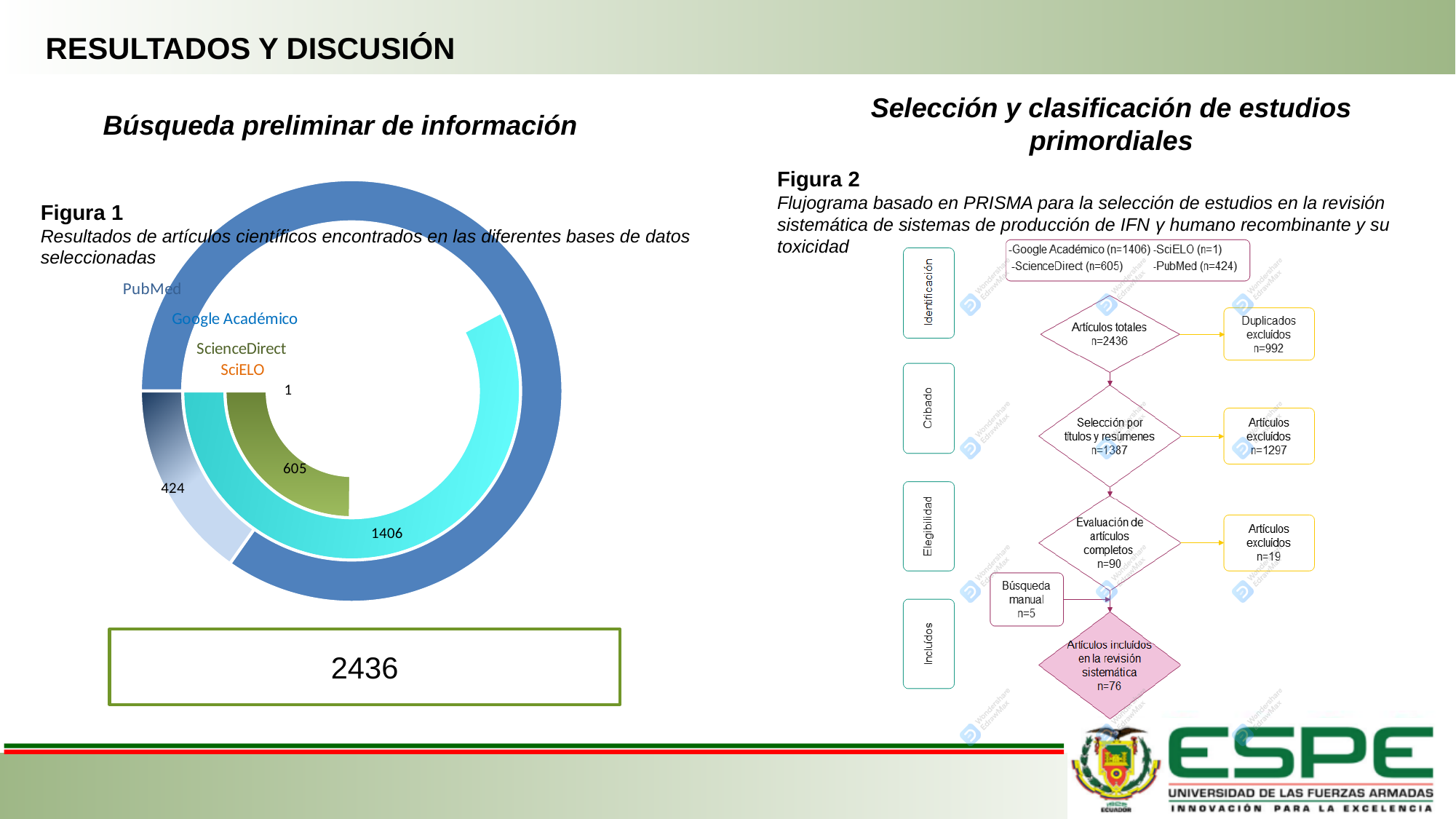
In Figura 1, what is the difference between the Google Académico and ScienceDirect values? 801 In Figura 1, how many articles were found in PubMed? 424 In Figura 1, how many articles were found in Google Académico? 1406 What total number of articles is shown in the box below Figura 1? 2436 In Figura 1, which database has the highest number of articles? Google Académico In Figura 1, which is larger, the value for PubMed or the value for ScienceDirect? ScienceDirect In Figura 1, how many articles were found in ScienceDirect? 605 In Figura 1, how many articles were found in SciELO? 1 In Figura 1, which database has the lowest number of articles? SciELO In Figura 1, what is the difference between the ScienceDirect and PubMed values? 181 What kind of chart is Figura 1? Doughnut chart How many databases are shown in Figura 1? 4